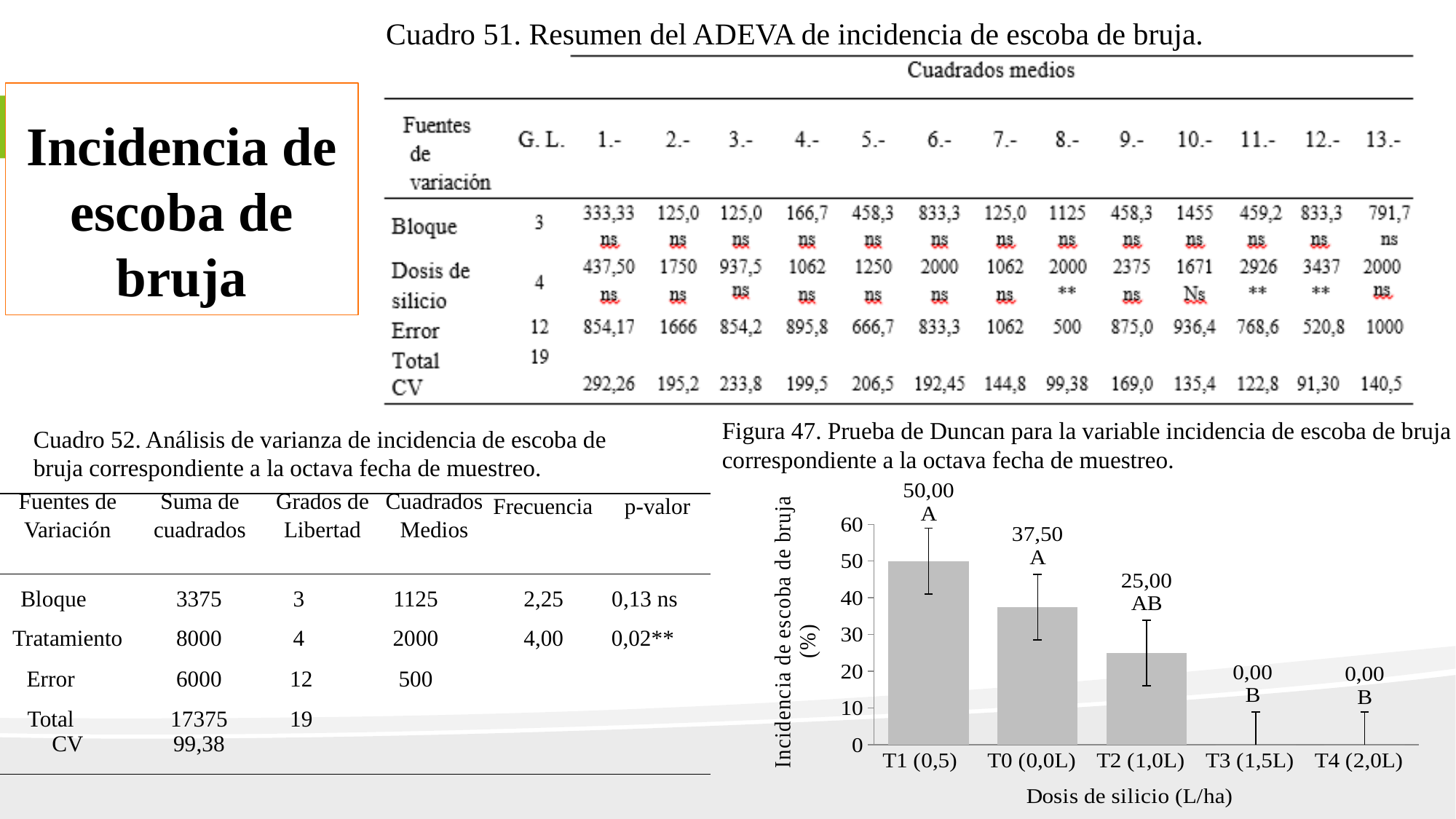
In Figura 47, what is the value for T0 (0,0L)? 37,50 In Figura 47, what is the value for T3 (1,5L)? 0,00 In Figura 47, what is the value for T1 (0,5)? 50,00 In Figura 47, what is the value for T2 (1,0L)? 25,00 How many treatments are shown on the x axis of Figura 47? 5 What is the x-axis title of Figura 47? Dosis de silicio (L/ha) In Figura 47, what is the difference between the values for T0 (0,0L) and T2 (1,0L)? 12,50 In Figura 47, is the value for T1 (0,5) greater or less than 40? greater What kind of chart is Figura 47? bar chart In Figura 47, which treatment has the highest incidence of escoba de bruja? T1 (0,5) In Figura 47, which is larger, the value for T0 (0,0L) or the value for T2 (1,0L)? T0 (0,0L) In Figura 47, what is the difference between the values for T1 (0,5) and T0 (0,0L)? 12,50